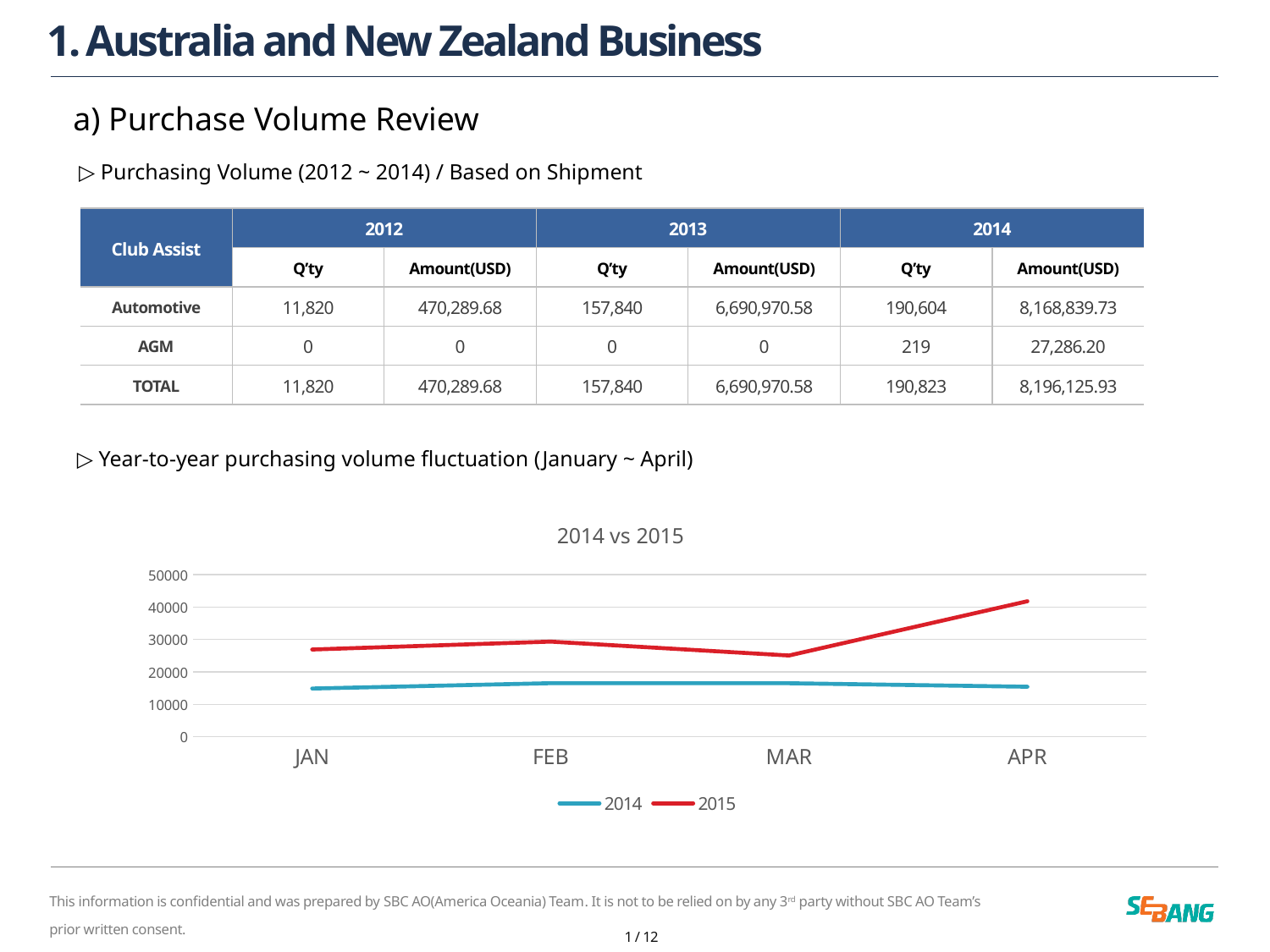
How many series does the chart's legend list? 2 In which month does the 2015 series reach its highest value? APR In April, which series has the larger value, 2014 or 2015? 2015 Does the 2015 series rise or fall from MAR to APR? rise Is the value for 2014 in JAN greater or less than 20000? less What kind of chart is shown under 'Year-to-year purchasing volume fluctuation'? line chart How many months are plotted along the x axis of the chart? 4 Which colour is used for the 2015 series in the chart? red Is the value for 2015 in APR greater or less than 40000? greater Is the value for 2015 in JAN greater or less than 20000? greater What is the title of the chart on the slide? 2014 vs 2015